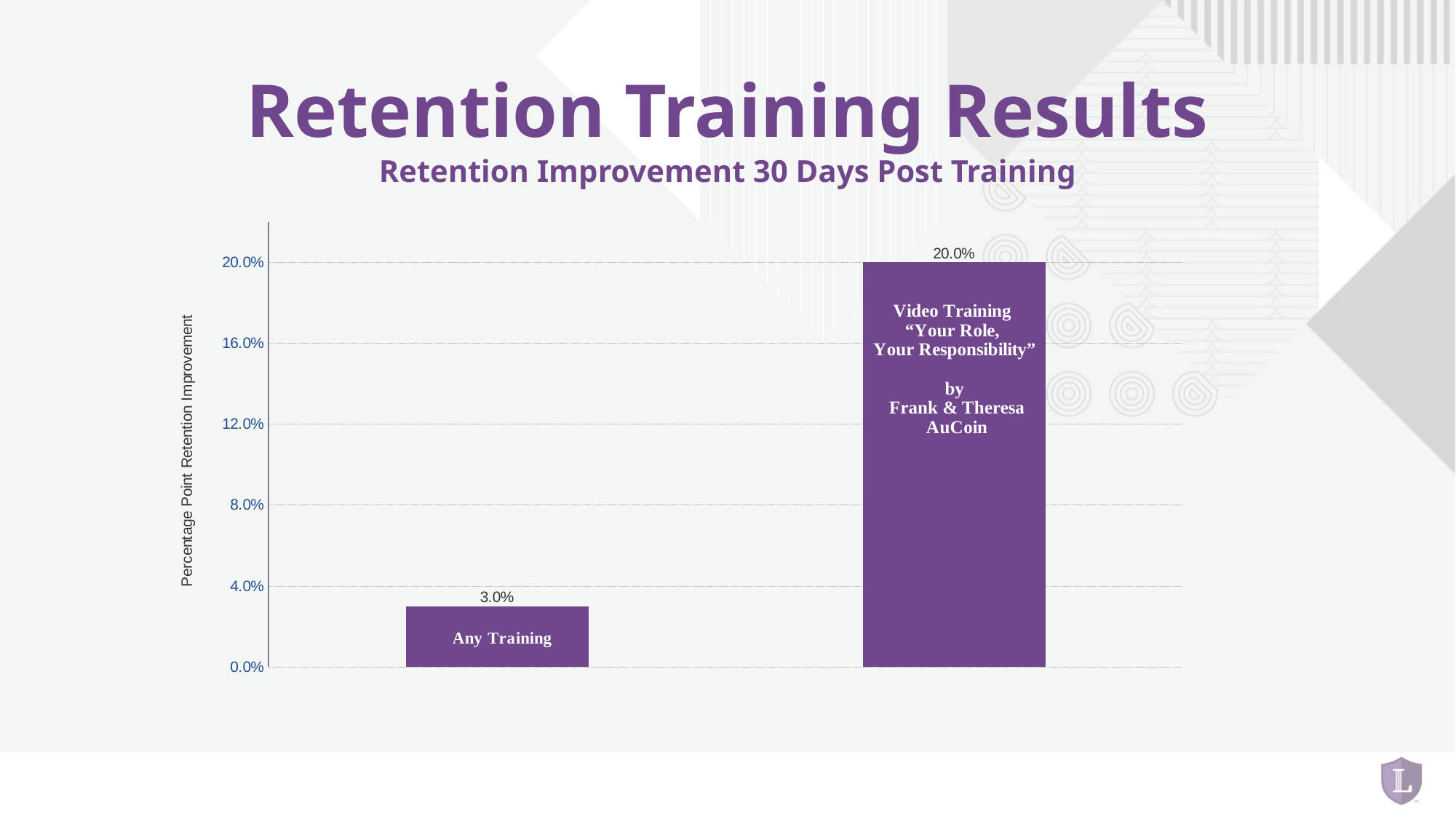
Is the value for Any Training greater or less than 4.0%? less Which bar shows the highest retention improvement? Video Training "Your Role, Your Responsibility" How many bars are plotted in the chart? 2 Is the value for the Video Training greater or less than 16.0%? greater What kind of chart is shown on the slide? Bar chart What is the label of the vertical axis? Percentage Point Retention Improvement What is the difference in retention improvement between the Video Training and Any Training? 17.0% What is the subtitle of the chart on the slide? Retention Improvement 30 Days Post Training What is the percentage point retention improvement for Any Training? 3.0% Which bar shows the lowest retention improvement? Any Training What is the percentage point retention improvement for the Video Training "Your Role, Your Responsibility" by Frank & Theresa AuCoin? 20.0% Which has a larger retention improvement, Any Training or the Video Training by Frank & Theresa AuCoin? Video Training